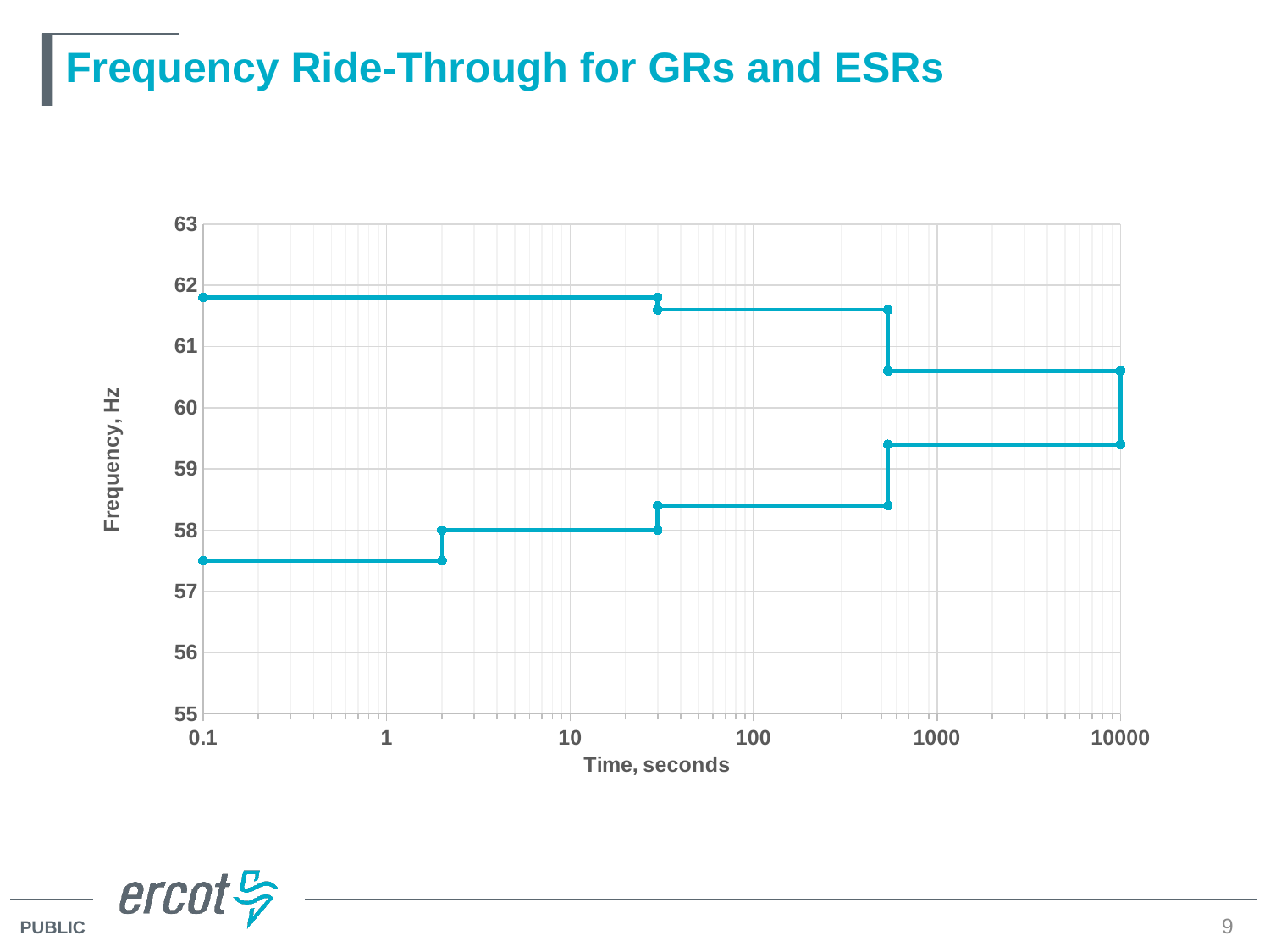
Is the value of the lower line at 10000 seconds greater or less than 59? greater Is the value of the upper line at 0.1 seconds greater or less than 61? greater What kind of chart is shown on the slide? Line chart Does the lower line rise or fall as time increases along the x axis? Rise Is the value of the upper line at 100 seconds greater or less than 61? greater What is the title of the chart? Frequency Ride-Through for GRs and ESRs Does the upper line rise or fall as time increases along the x axis? Fall What is the label of the y axis? Frequency, Hz